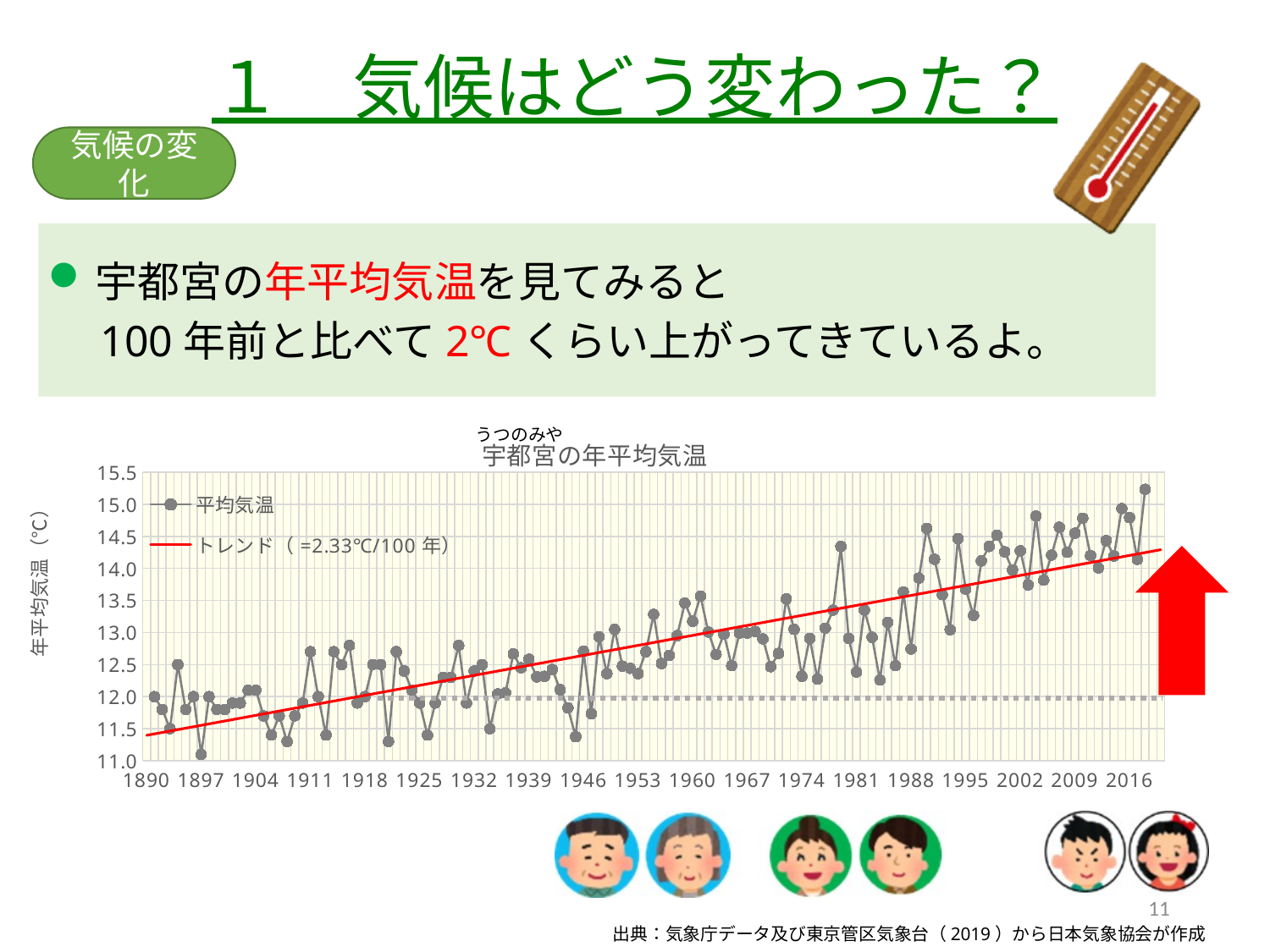
Is the value for 1946 greater or less than 12.0? greater Is the value for 1897 greater or less than 11.5? less Which is larger, the value for 1890 or the value for 2002? 2002 What is the title of the chart? 宇都宮の年平均気温 Do the annual mean temperature values generally rise or fall from 1890 to 2016? rise What trend rate is given in the legend for the トレンド line? =2.33℃/100 年 Which year has the lowest annual mean temperature on the chart? 1897 How many series does the chart legend list? 2 Is the value for 1890 greater or less than 12.5? less What kind of chart is shown on the slide? line chart What is the label on the vertical axis of the chart? 年平均気温（℃）